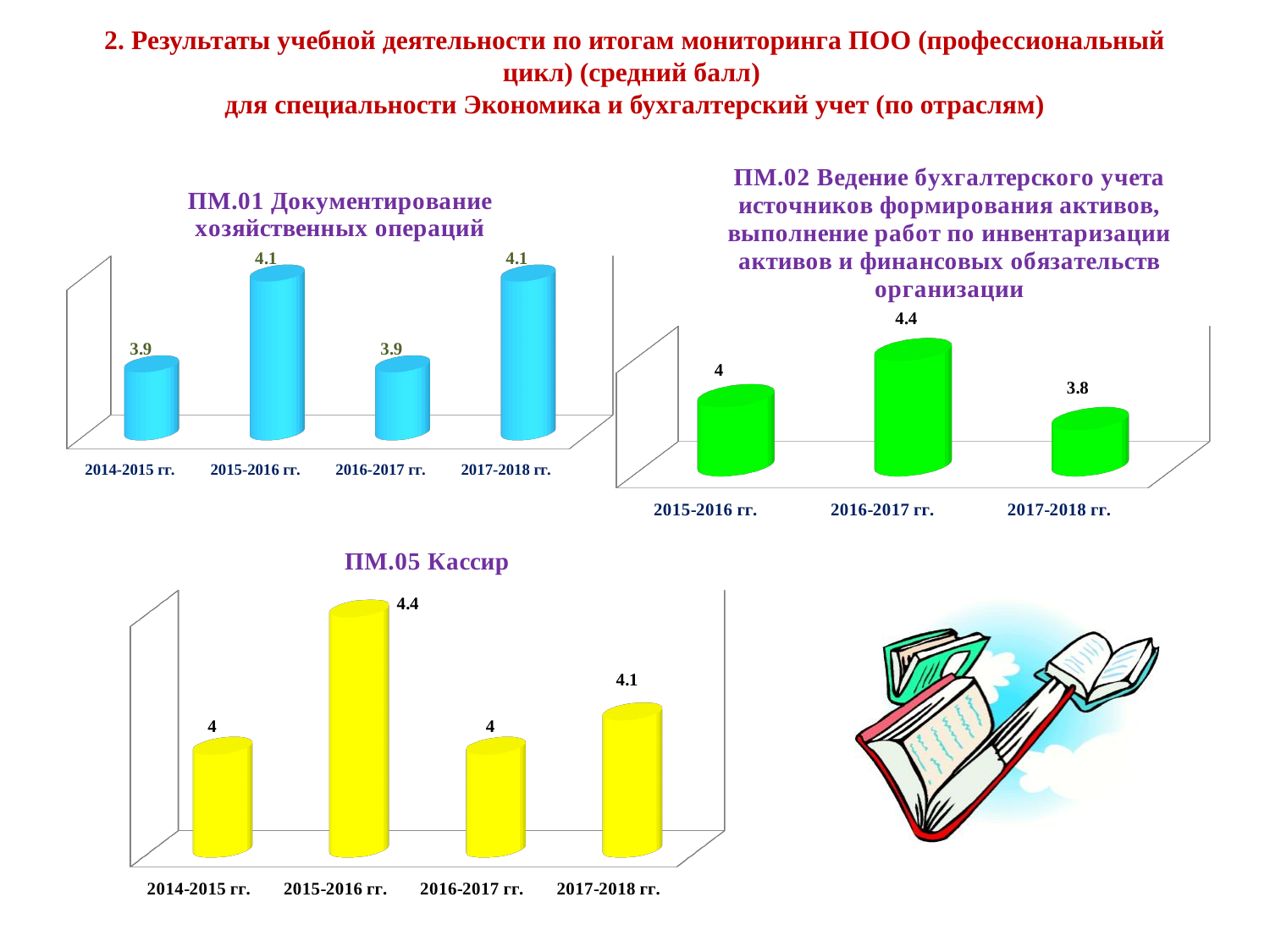
In the ПМ.01 Документирование хозяйственных операций chart, how many categories are shown on the x axis? 4 What colour are the bars in the ПМ.02 Ведение бухгалтерского учета chart? Green In the ПМ.05 Кассир chart, which is larger, the value for 2017-2018 гг. or the value for 2016-2017 гг.? 2017-2018 гг. In the ПМ.01 Документирование хозяйственных операций chart, what is the value for 2016-2017 гг.? 3.9 In the ПМ.02 Ведение бухгалтерского учета chart, what is the value for 2015-2016 гг.? 4 In the ПМ.05 Кассир chart, what is the difference between the values for 2015-2016 гг. and 2014-2015 гг.? 0.4 In the ПМ.02 Ведение бухгалтерского учета chart, which year has the highest value? 2016-2017 гг. In the ПМ.02 Ведение бухгалтерского учета chart, which year has the lowest value? 2017-2018 гг. In the ПМ.01 Документирование хозяйственных операций chart, what is the value for 2015-2016 гг.? 4.1 What type of chart is the ПМ.05 Кассир chart? Bar chart In the ПМ.05 Кассир chart, what is the value for 2015-2016 гг.? 4.4 In the ПМ.02 Ведение бухгалтерского учета chart, what is the difference between the values for 2016-2017 гг. and 2017-2018 гг.? 0.6